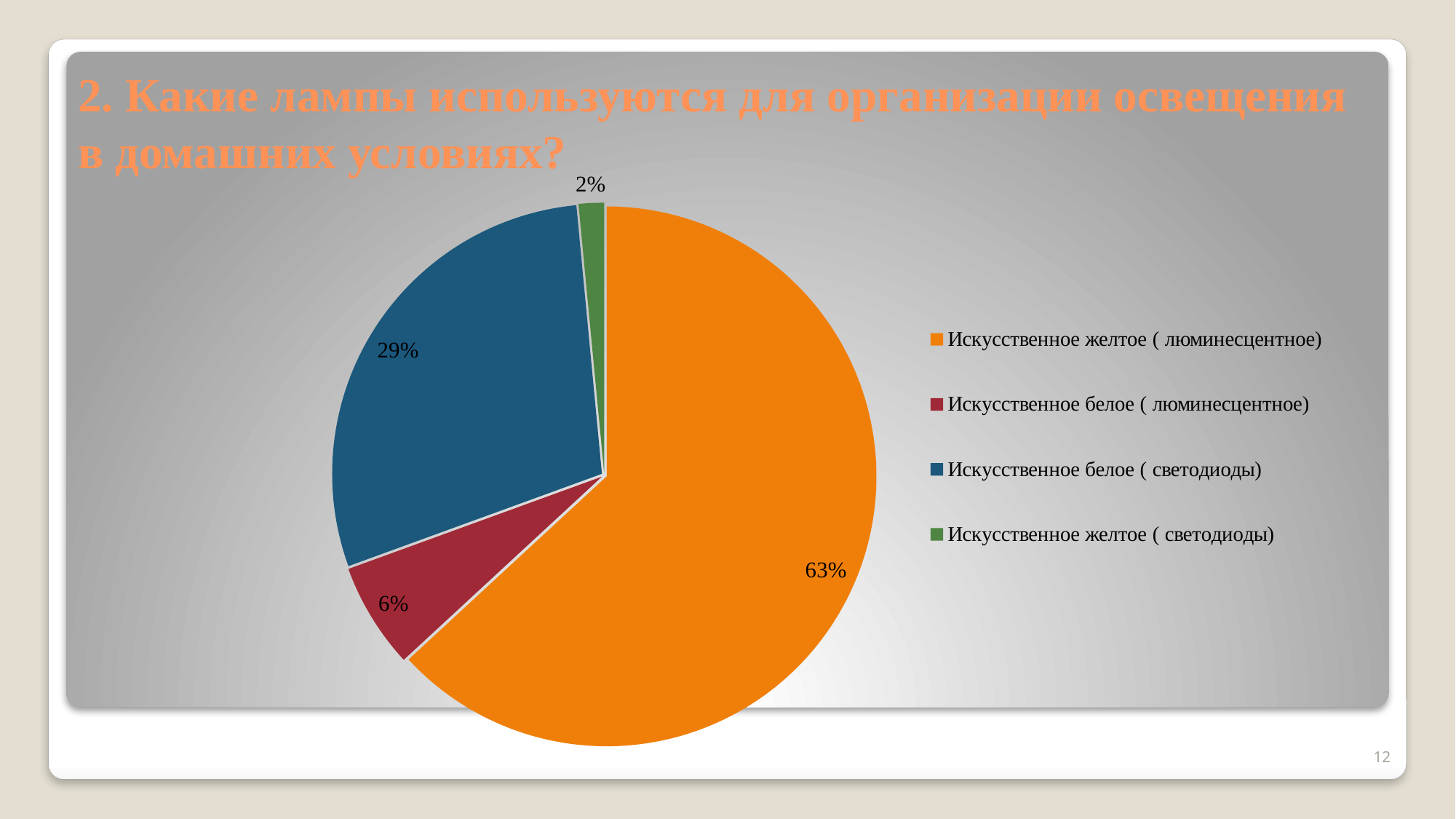
What kind of chart is shown on the slide? pie chart How many categories does the pie chart have? 4 What is the difference between the shares of "Искусственное белое ( люминесцентное)" and "Искусственное желтое ( светодиоды)"? 4% What share of the pie does "Искусственное желтое ( люминесцентное)" have? 63% Which is larger: the share for "Искусственное белое ( люминесцентное)" or for "Искусственное желтое ( светодиоды)"? Искусственное белое ( люминесцентное) What is the value for "Искусственное белое ( люминесцентное)"? 6% Which category has the smallest slice of the pie? Искусственное желтое ( светодиоды) Which category has the largest slice of the pie? Искусственное желтое ( люминесцентное) What colour is the slice for "Искусственное белое ( светодиоды)"? blue What share of the pie does "Искусственное белое ( светодиоды)" have? 29% What is the difference between the shares of "Искусственное желтое ( люминесцентное)" and "Искусственное белое ( светодиоды)"? 34% What is the value for "Искусственное желтое ( светодиоды)"? 2%